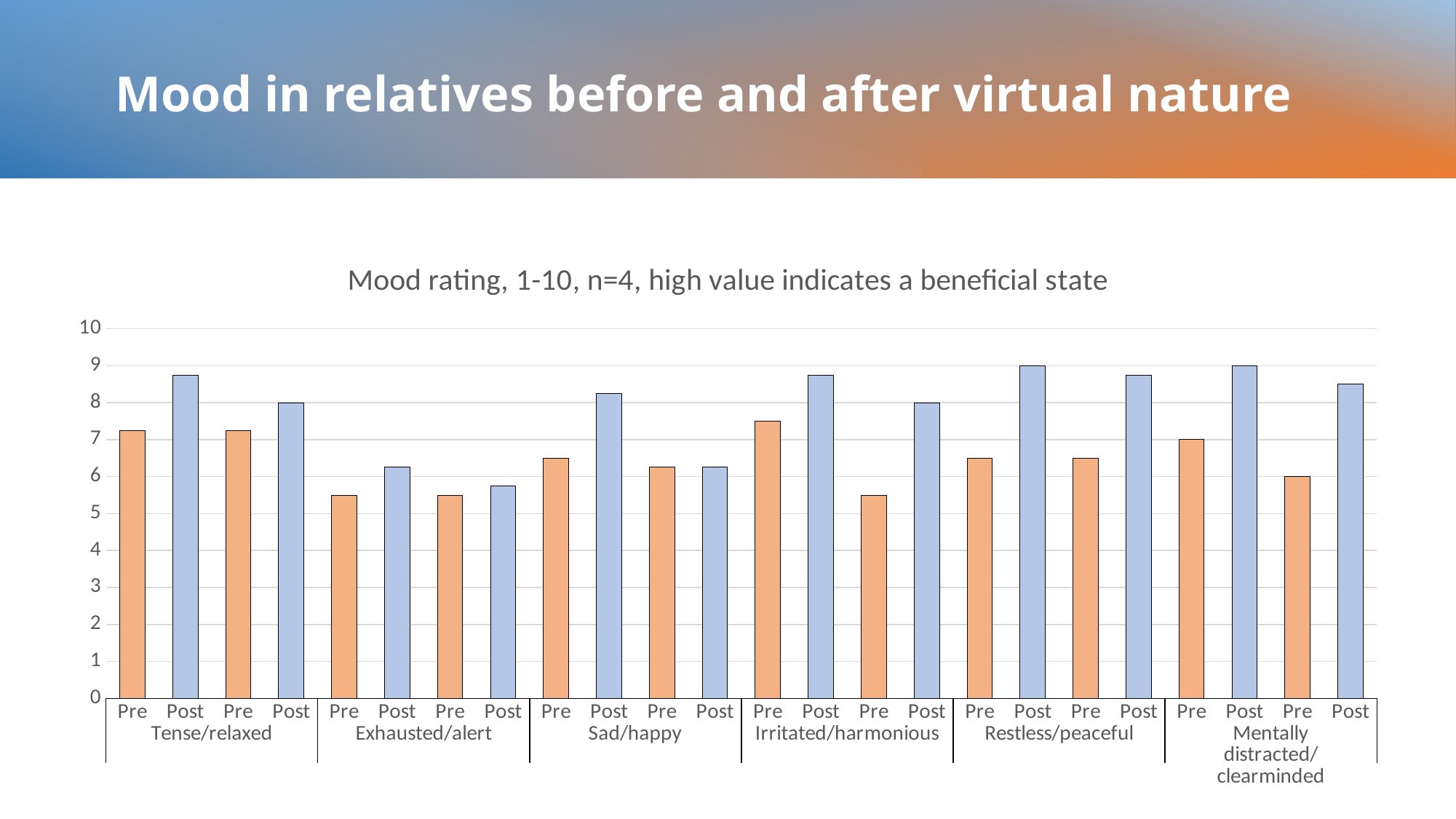
What is the value of the first Post bar in the Restless/peaceful group? 9 Is the value of the first Post bar in the Sad/happy group greater or less than 8? greater In the Tense/relaxed group, which is larger: the first Pre bar or the first Post bar? Post What is the value of the second Post bar in the Tense/relaxed group? 8 What kind of chart is shown on the slide? bar chart How many bars are plotted in total on the chart? 24 Is the value of the first Pre bar in the Exhausted/alert group greater or less than 5? greater What is the value of the second Post bar in the Irritated/harmonious group? 8 What is the chart's title? Mood rating, 1-10, n=4, high value indicates a beneficial state What is the value of the second Pre bar in the Mentally distracted/clearminded group? 6 What is the maximum value shown on the vertical axis? 10 How many mood dimensions (category groups) are shown along the x axis? 6